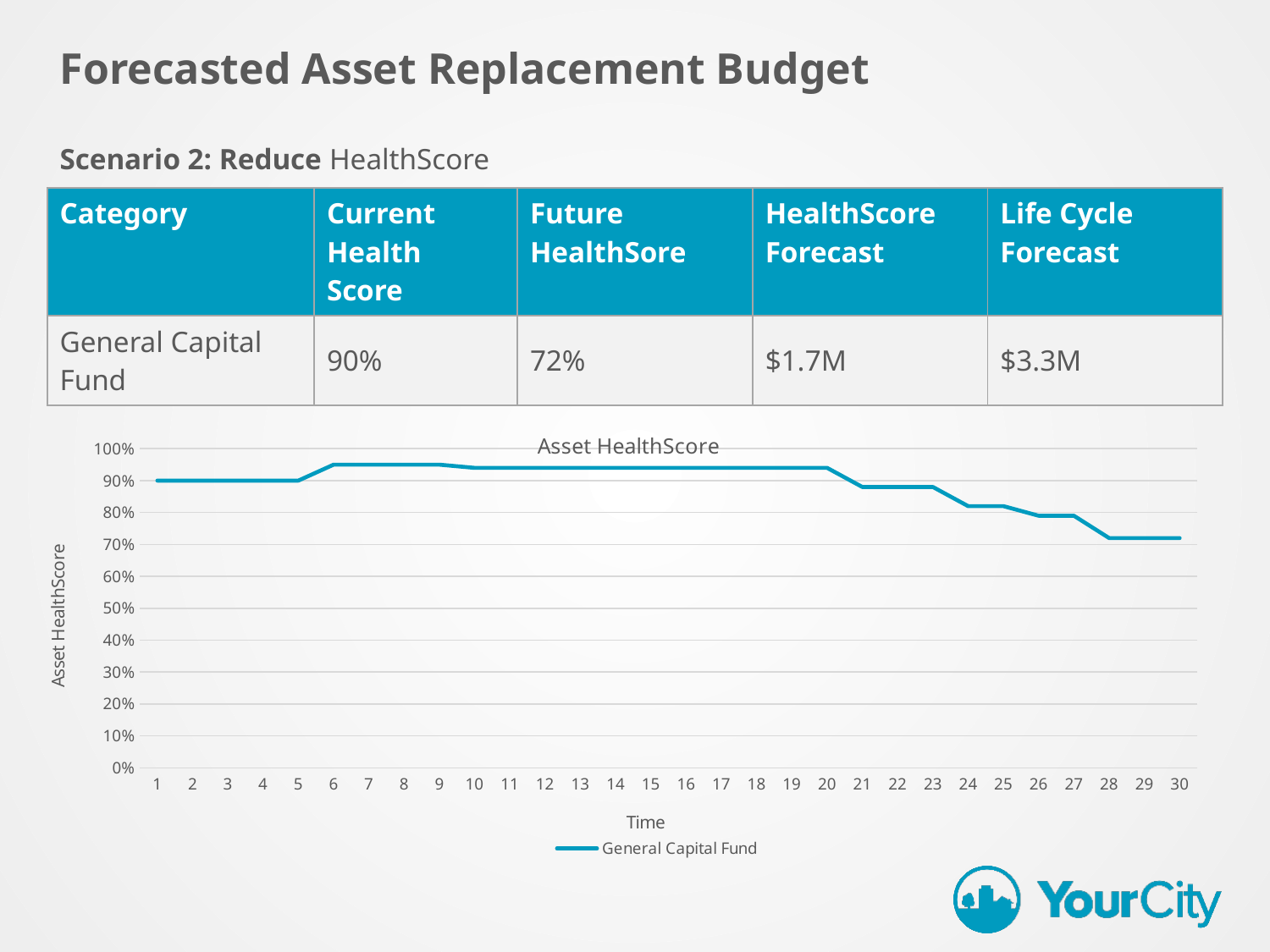
Is the value for General Capital Fund at time 30 greater or less than 80%? less Is the value for General Capital Fund at time 28 greater or less than 80%? less How many series does the chart legend list? 1 What kind of chart is shown on the slide? line chart Overall, does the General Capital Fund line rise or fall from time 1 to time 30? fall What series name appears in the chart legend? General Capital Fund Is the value for General Capital Fund at time 8 greater or less than 90%? greater What is the title of the chart? Asset HealthScore What is the value of General Capital Fund at time 1? 90% How many time points are shown along the x axis of the chart? 30 Which is larger, the value for General Capital Fund at time 10 or at time 30? time 10